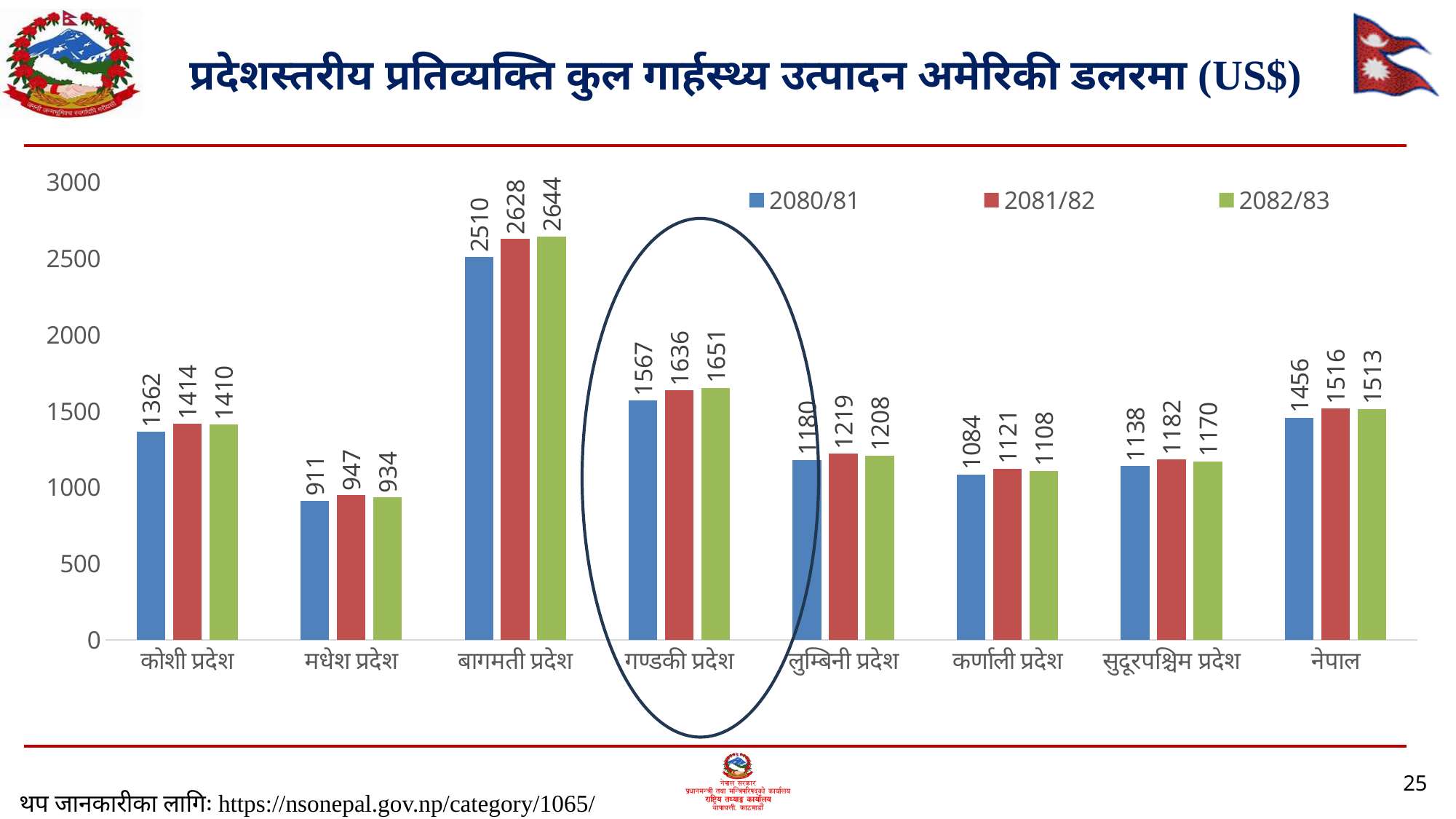
Which is larger: the 2082/83 value for कर्णाली प्रदेश or the 2082/83 value for सुदूरपश्चिम प्रदेश? सुदूरपश्चिम प्रदेश What is the value for नेपाल in the 2081/82 series? 1516 Which category has the lowest value in the 2082/83 series? मधेश प्रदेश What is the value for बागमती प्रदेश in the 2082/83 series? 2644 How many series does the legend list? 3 How many categories are shown on the x axis? 8 Which category is circled on the chart? गण्डकी प्रदेश What is the difference between the 2082/83 and 2080/81 values for गण्डकी प्रदेश? 84 What kind of chart is shown on the slide? Bar chart Which category has the highest value in the 2081/82 series? बागमती प्रदेश Does the value for लुम्बिनी प्रदेश rise or fall from 2080/81 to 2081/82? Rise What is the value for मधेश प्रदेश in the 2080/81 series? 911